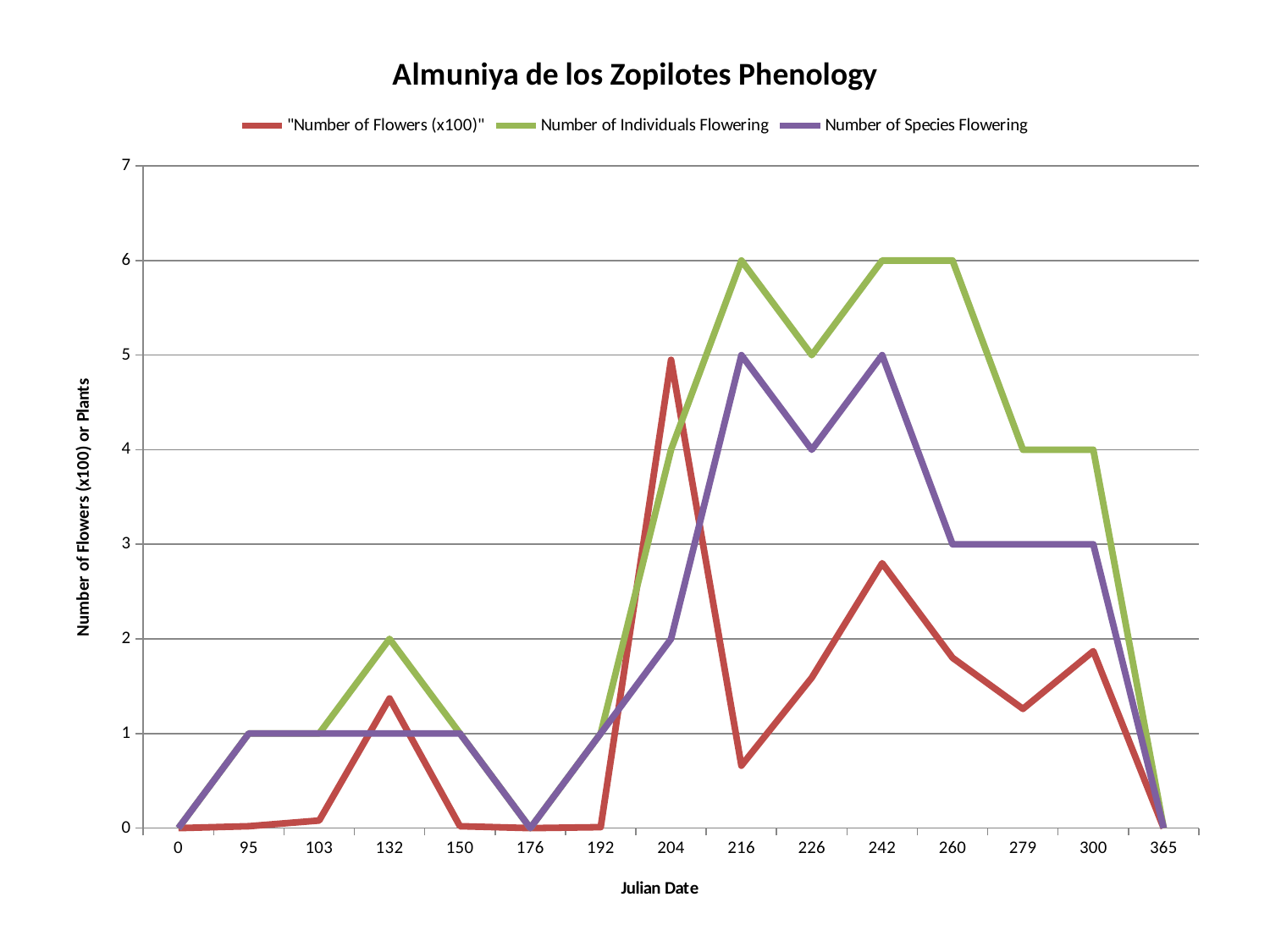
At Julian Date 260, which is larger: Number of Individuals Flowering or Number of Species Flowering? Number of Individuals Flowering What kind of chart is shown on the slide? line chart What is the title of the x axis? Julian Date Is the value of Number of Flowers (x100) at Julian Date 204 greater or less than 4? greater How many series does the legend list? 3 What is the value of Number of Species Flowering at Julian Date 260? 3 How many Julian Date points are plotted along the x axis? 15 What is the value of Number of Individuals Flowering at Julian Date 216? 6 At which Julian Date does the Number of Flowers (x100) series reach its highest value? 204 What is the value of Number of Species Flowering at Julian Date 216? 5 What is the difference between Number of Individuals Flowering and Number of Species Flowering at Julian Date 226? 1 What is the value of Number of Individuals Flowering at Julian Date 132? 2